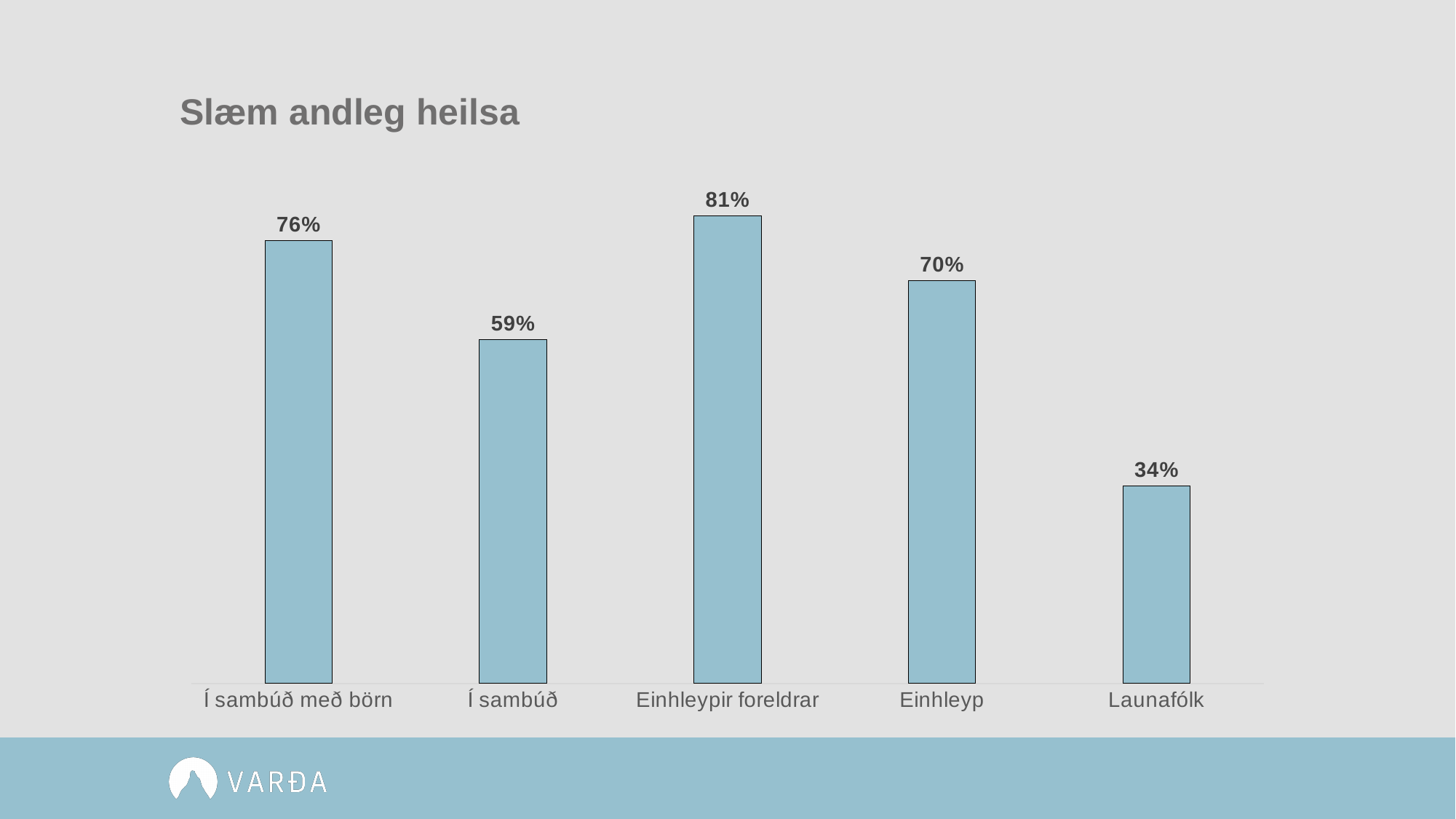
Which category has the lowest value? Launafólk What is the value for Í sambúð? 59% What kind of chart is shown on the slide? Bar chart What is the value for Launafólk? 34% What is the title of the chart? Slæm andleg heilsa What is the value for Í sambúð með börn? 76% What is the difference between the values for Einhleypir foreldrar and Launafólk? 47% Which category has the highest value? Einhleypir foreldrar Which is larger, the value for Í sambúð með börn or the value for Einhleyp? Í sambúð með börn What is the value for Einhleypir foreldrar? 81% What is the value for Einhleyp? 70% How many categories are shown in the chart? 5